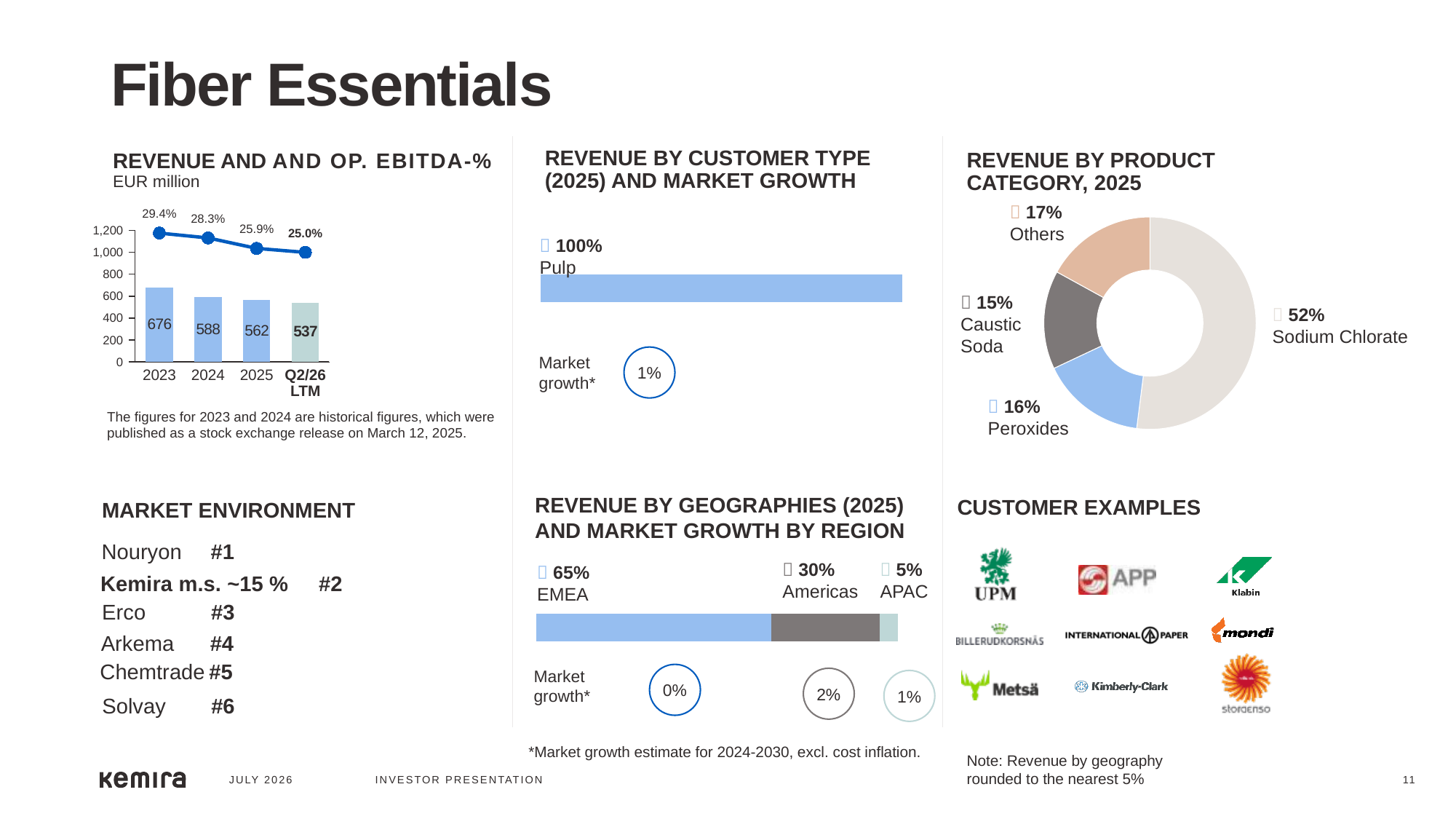
In the 'Revenue and Op. EBITDA-%' chart, which period has the highest revenue? 2023 In the 'Revenue by Geographies (2025)' chart, which region has the highest market growth? Americas In the 'Revenue by Product Category, 2025' chart, which category has the smallest share? Caustic Soda In the 'Revenue and Op. EBITDA-%' chart, does the Op. EBITDA-% rise or fall from 2023 to Q2/26 LTM? Fall In the 'Revenue and Op. EBITDA-%' chart, which period has the lowest revenue? Q2/26 LTM In the 'Revenue by Product Category, 2025' chart, how many categories are shown? 4 In the 'Revenue by Product Category, 2025' chart, what share does Sodium Chlorate have? 52% In the 'Revenue and Op. EBITDA-%' chart, how many periods are shown on the x axis? 4 In the 'Revenue and Op. EBITDA-%' chart, what is the Op. EBITDA-% for Q2/26 LTM? 25.0% In the 'Revenue by Geographies (2025)' chart, what share of revenue comes from Americas? 30% In the 'Revenue and Op. EBITDA-%' chart, what is the difference in revenue between 2023 and 2024? 88 In the 'Revenue and Op. EBITDA-%' chart, what was revenue in 2023? 676